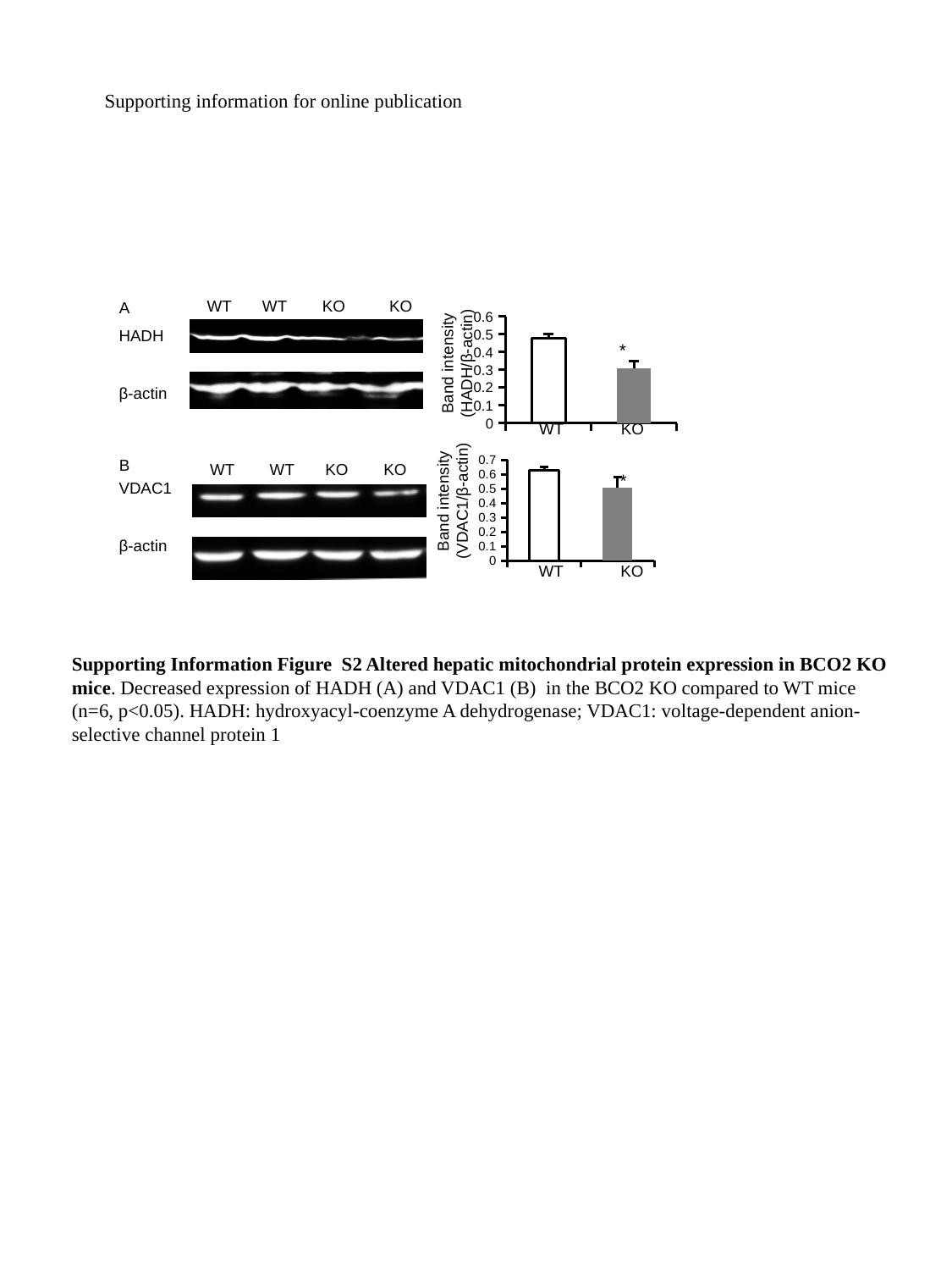
In the panel A chart (HADH/β-actin band intensity), is the value for WT greater or less than 0.4? greater In the panel B chart (VDAC1/β-actin band intensity), which is larger, the value for WT or the value for KO? WT In the panel B chart (VDAC1/β-actin band intensity), which category has the lower band intensity? KO In the panel A chart (HADH/β-actin band intensity), how many categories are plotted on the x axis? 2 In the panel B chart (VDAC1/β-actin band intensity), is the value for KO greater or less than 0.6? less In the panel B chart (VDAC1/β-actin band intensity), how many bars are plotted? 2 In the panel A chart (HADH/β-actin band intensity), what kind of chart is shown? bar chart In the panel A chart (HADH/β-actin band intensity), which category has the higher band intensity? WT In the panel A chart (HADH/β-actin band intensity), is the value for KO greater or less than 0.4? less In the panel A chart (HADH/β-actin band intensity), what is the highest tick value shown on the y axis? 0.6 In the panel B chart (VDAC1/β-actin band intensity), what is the highest tick value shown on the y axis? 0.7